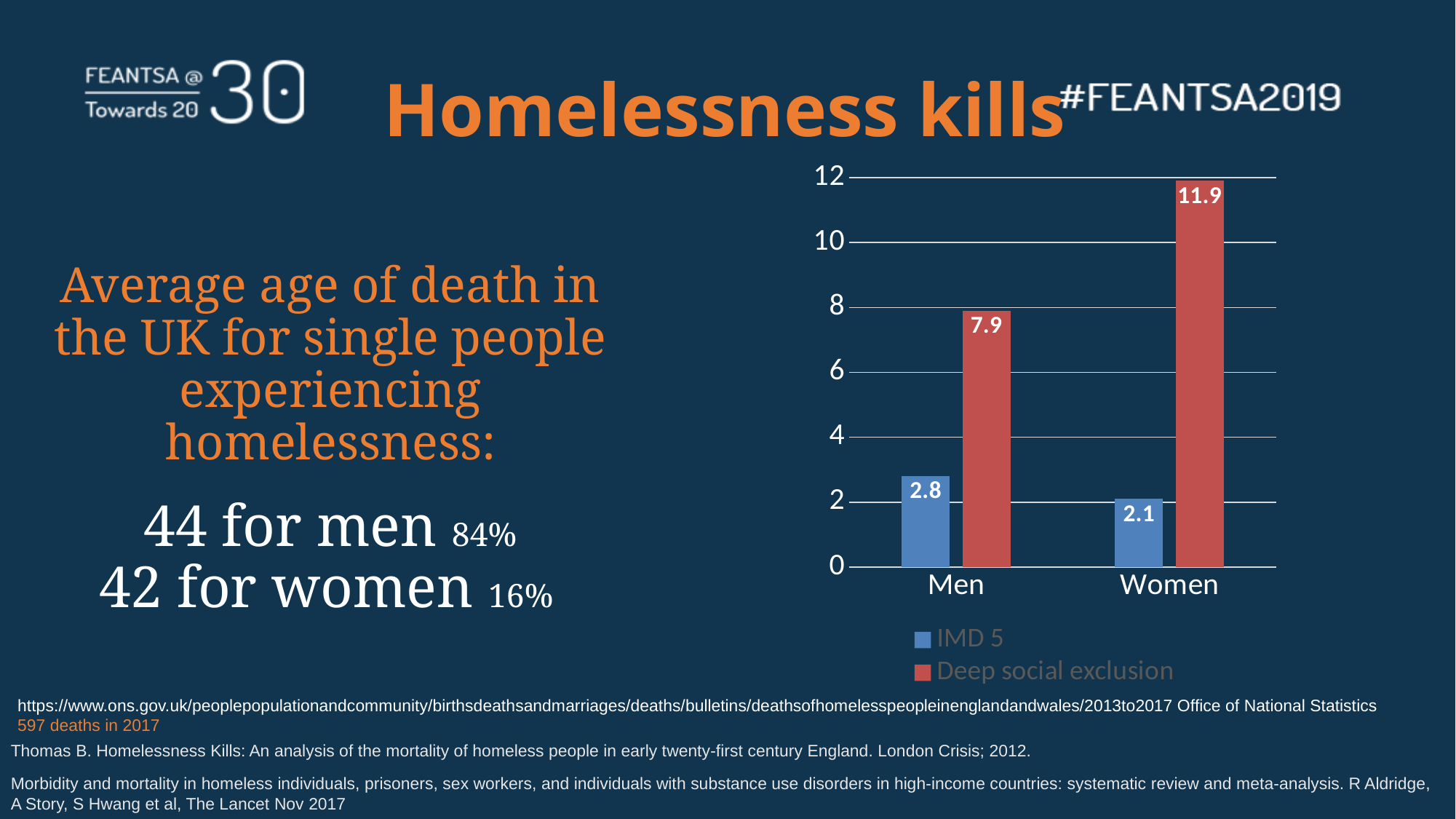
What is the value for Men in the Deep social exclusion series? 7.9 What colour are the Deep social exclusion bars? Red What is the value for Men in the IMD 5 series? 2.8 Which is larger: the IMD 5 value for Men or the IMD 5 value for Women? Men Which category has the highest Deep social exclusion value? Women What is the difference between the Deep social exclusion values for Women and Men? 4.0 What is the value for Women in the IMD 5 series? 2.1 How many categories are shown on the x axis of the chart? 2 What is the value for Women in the Deep social exclusion series? 11.9 How many series does the chart legend list? 2 What kind of chart is shown on the slide? Bar chart Which category has the lowest IMD 5 value? Women